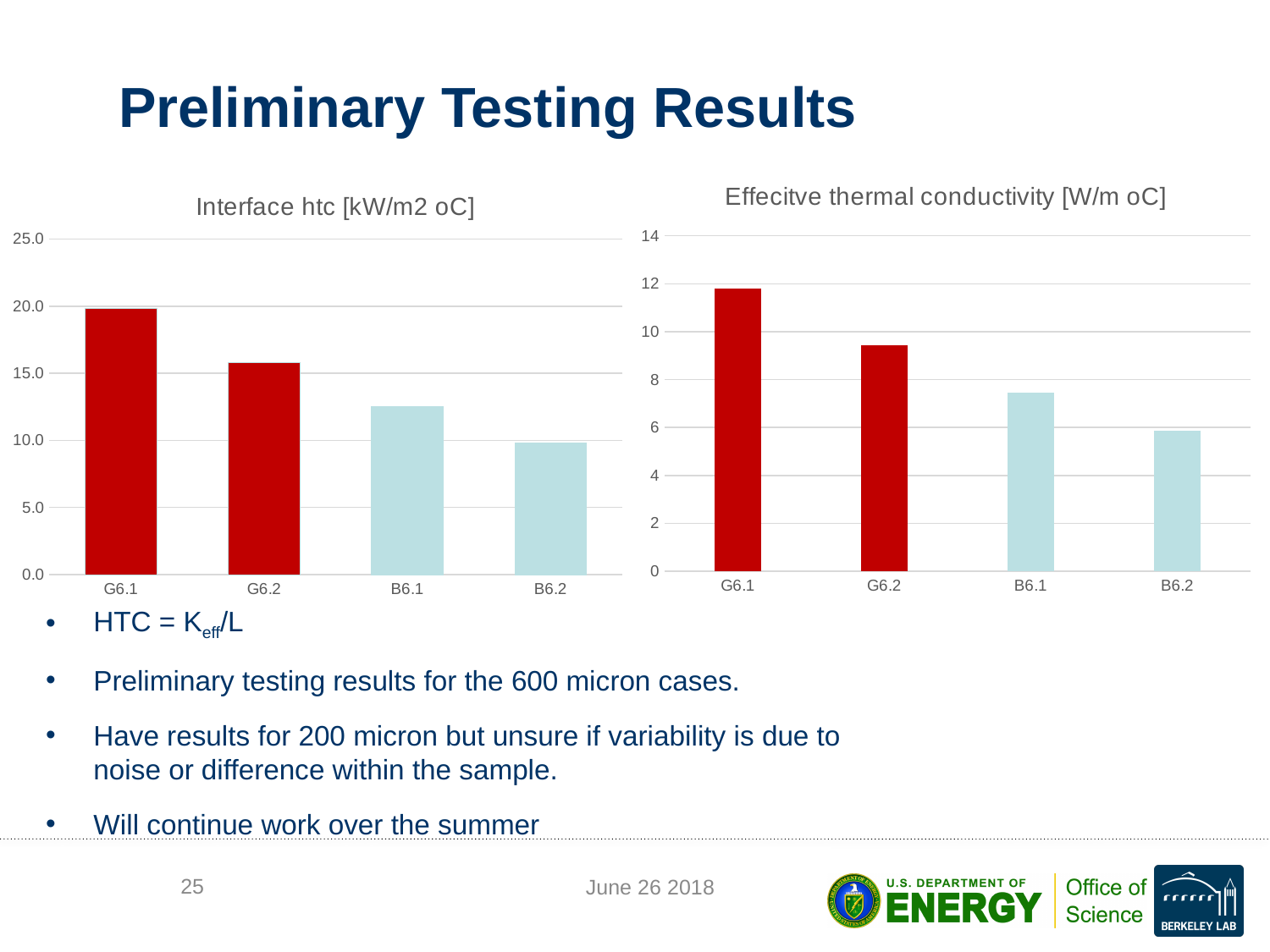
In the Effecitve thermal conductivity chart, which is larger, the value for G6.2 or the value for B6.1? G6.2 In the Interface htc chart, which category has the highest value? G6.1 In the Effecitve thermal conductivity chart, which category has the lowest value? B6.2 In the Interface htc chart, how many categories are shown on the x axis? 4 In the Effecitve thermal conductivity chart, is the value for G6.2 greater or less than 8? greater In the Effecitve thermal conductivity chart, which category has the highest value? G6.1 In the Interface htc chart, which category has the lowest value? B6.2 In the Effecitve thermal conductivity chart, is the value for B6.1 greater or less than 8? less In the Interface htc chart, do the values rise or fall from G6.1 to B6.2? fall What kind of chart is the Effecitve thermal conductivity chart? bar chart In the Interface htc chart, is the value for G6.1 greater or less than 15.0? greater